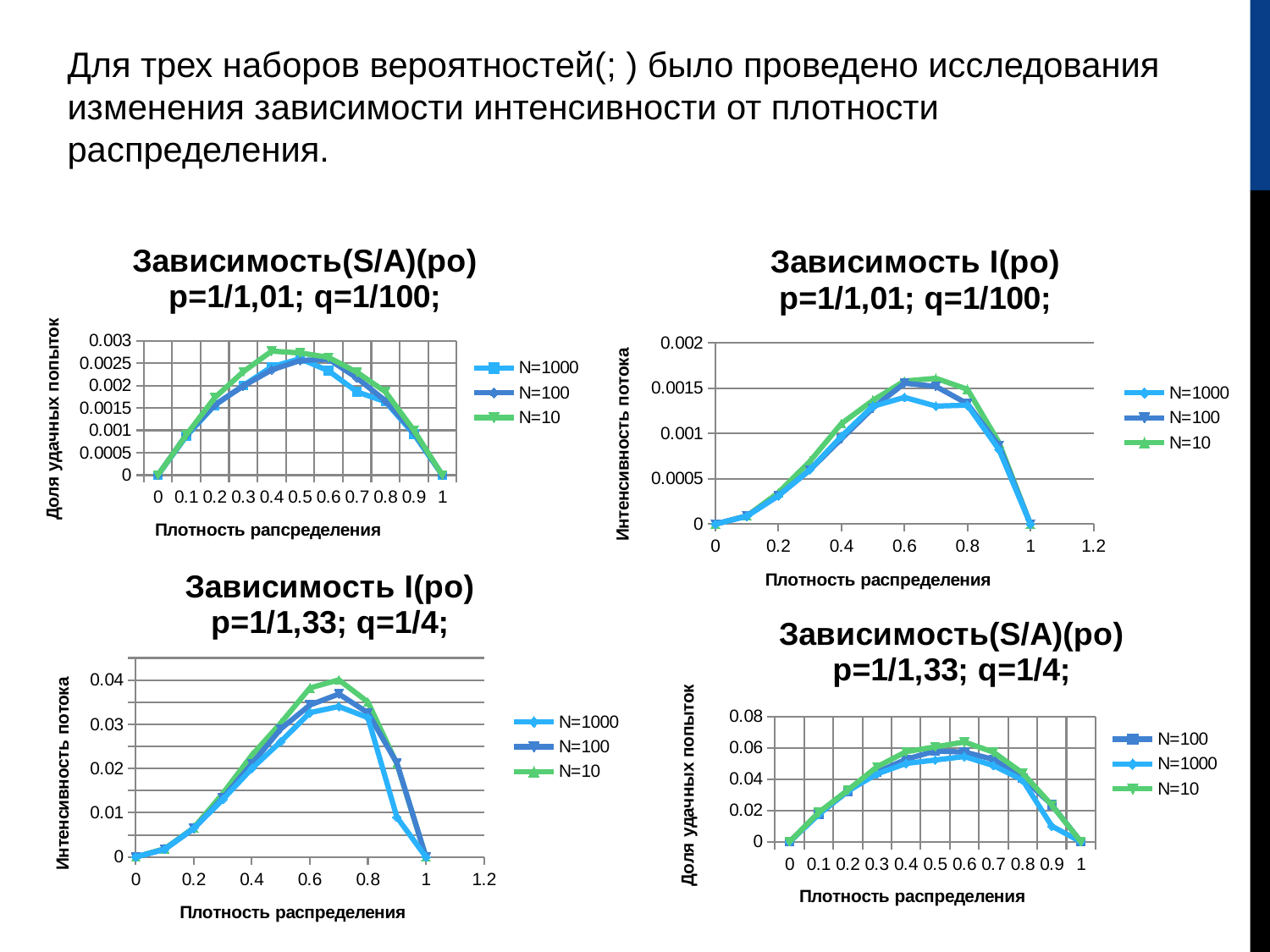
In the top-left chart "Зависимость(S/A)(ро) p=1/1,01; q=1/100;", how do the values change as the x axis goes from 0 to 1? rise then fall In the bottom-right chart "Зависимость(S/A)(ро) p=1/1,33; q=1/4;", is the value of N=10 at x=0.2 greater or less than 0.02? greater What kind of chart is the top-left chart titled "Зависимость(S/A)(ро) p=1/1,01; q=1/100;"? line chart In the bottom-left chart "Зависимость I(ро) p=1/1,33; q=1/4;", which series reaches the highest peak value? N=10 How many series does the legend of the top-right chart "Зависимость I(ро) p=1/1,01; q=1/100;" list? 3 In the bottom-left chart "Зависимость I(ро) p=1/1,33; q=1/4;", is the value of N=10 at x=0.7 greater or less than 0.03? greater In the bottom-right chart "Зависимость(S/A)(ро) p=1/1,33; q=1/4;", which series is listed first in the legend? N=100 In the top-left chart "Зависимость(S/A)(ро) p=1/1,01; q=1/100;", is the value of N=10 at x=0.4 greater or less than 0.0025? greater In the top-left chart "Зависимость(S/A)(ро) p=1/1,01; q=1/100;", how many x-axis tick values are shown from 0 to 1? 11 What is the y-axis title of the bottom-left chart "Зависимость I(ро) p=1/1,33; q=1/4;"? Интенсивность потока